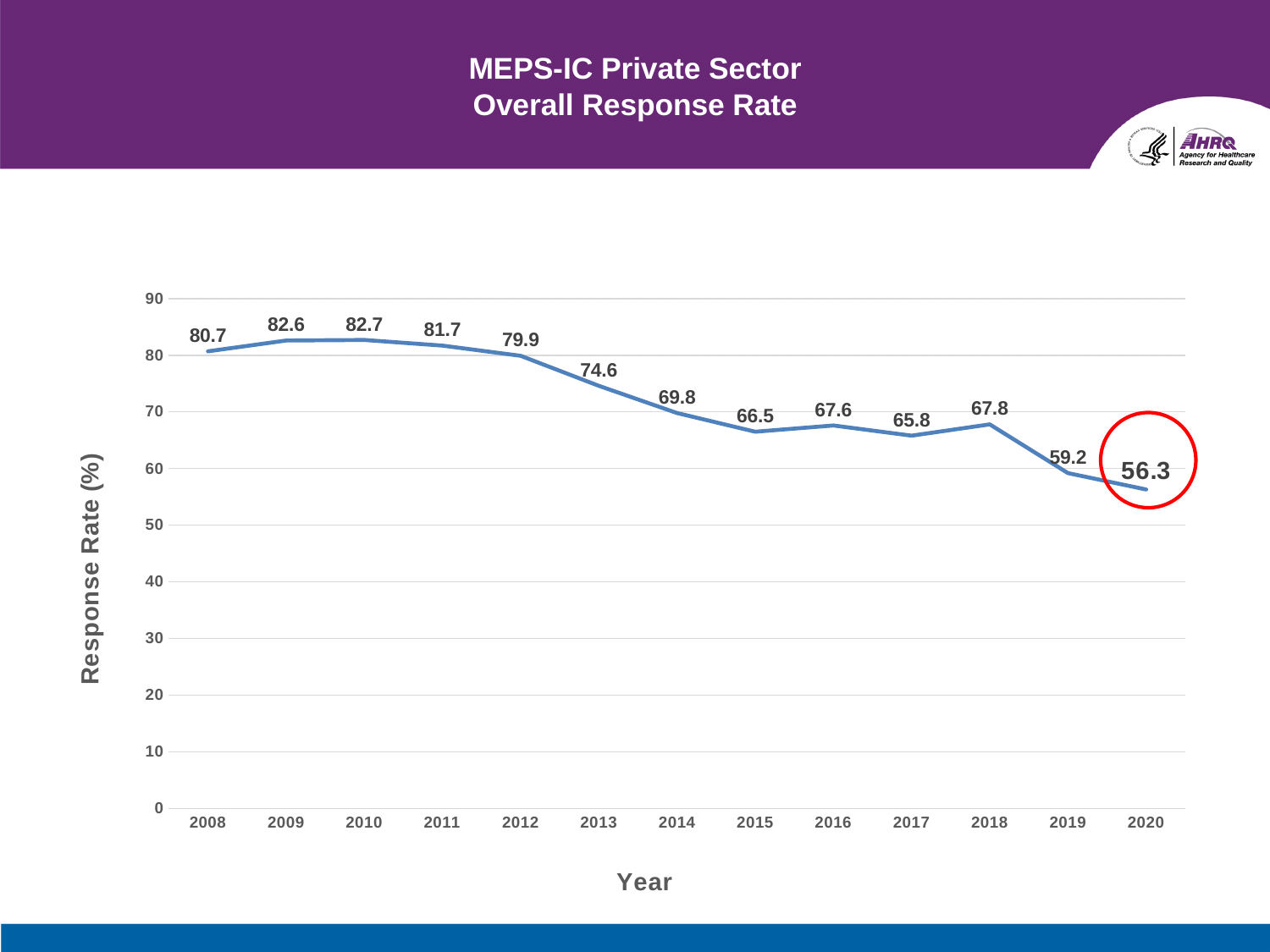
What is the difference between the response rate in 2008 and in 2020? 24.4 What was the overall response rate in 2020? 56.3 Does the response rate generally rise or fall from 2010 to 2020? fall Which year had a higher response rate, 2016 or 2017? 2016 Which year had the highest response rate? 2010 What was the overall response rate in 2013? 74.6 What kind of chart is shown on the slide? line chart What is the label on the y axis of the chart? Response Rate (%) How many years are plotted on the chart? 13 Which year had the lowest response rate? 2020 What was the overall response rate in 2008? 80.7 Is the response rate for 2019 greater or less than 60? less